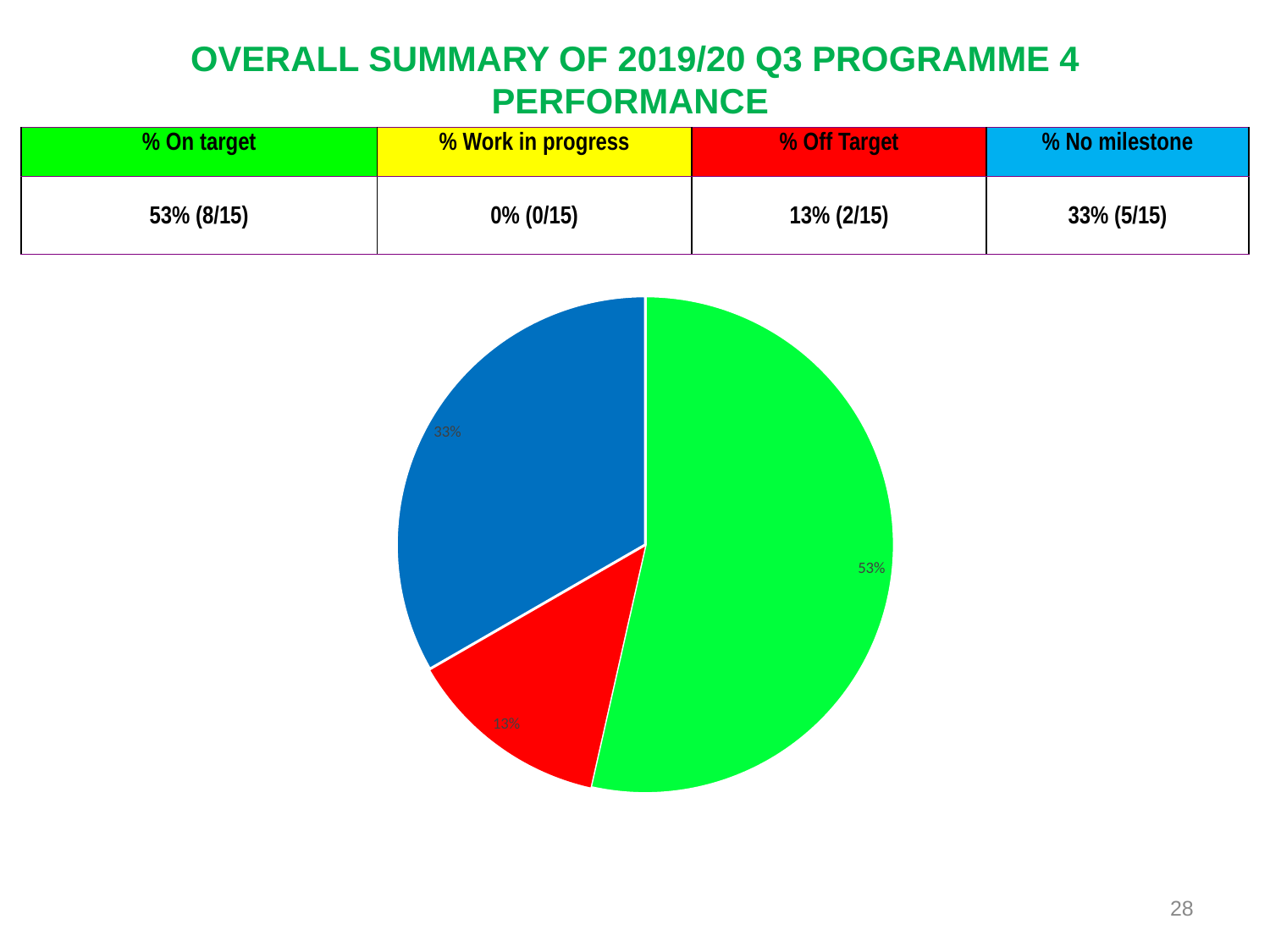
Which slice of the pie chart is the smallest? the red slice (13%) What kind of chart is shown on the slide? pie chart What is the difference in percentage points between the green slice and the blue slice of the pie chart? 20 What percentage is labelled on the red slice of the pie chart? 13% Which slice of the pie chart is the largest? the green slice (53%) What share of the pie does the green slice represent? 53% How many slices are visible in the pie chart? 3 Does the pie chart have a legend? No According to the table above the pie chart, what percentage of milestones are off target? 13% (2/15) Which is larger in the pie chart, the blue slice or the red slice? the blue slice What percentage is labelled on the blue slice of the pie chart? 33% What percentage is labelled on the green slice of the pie chart? 53%